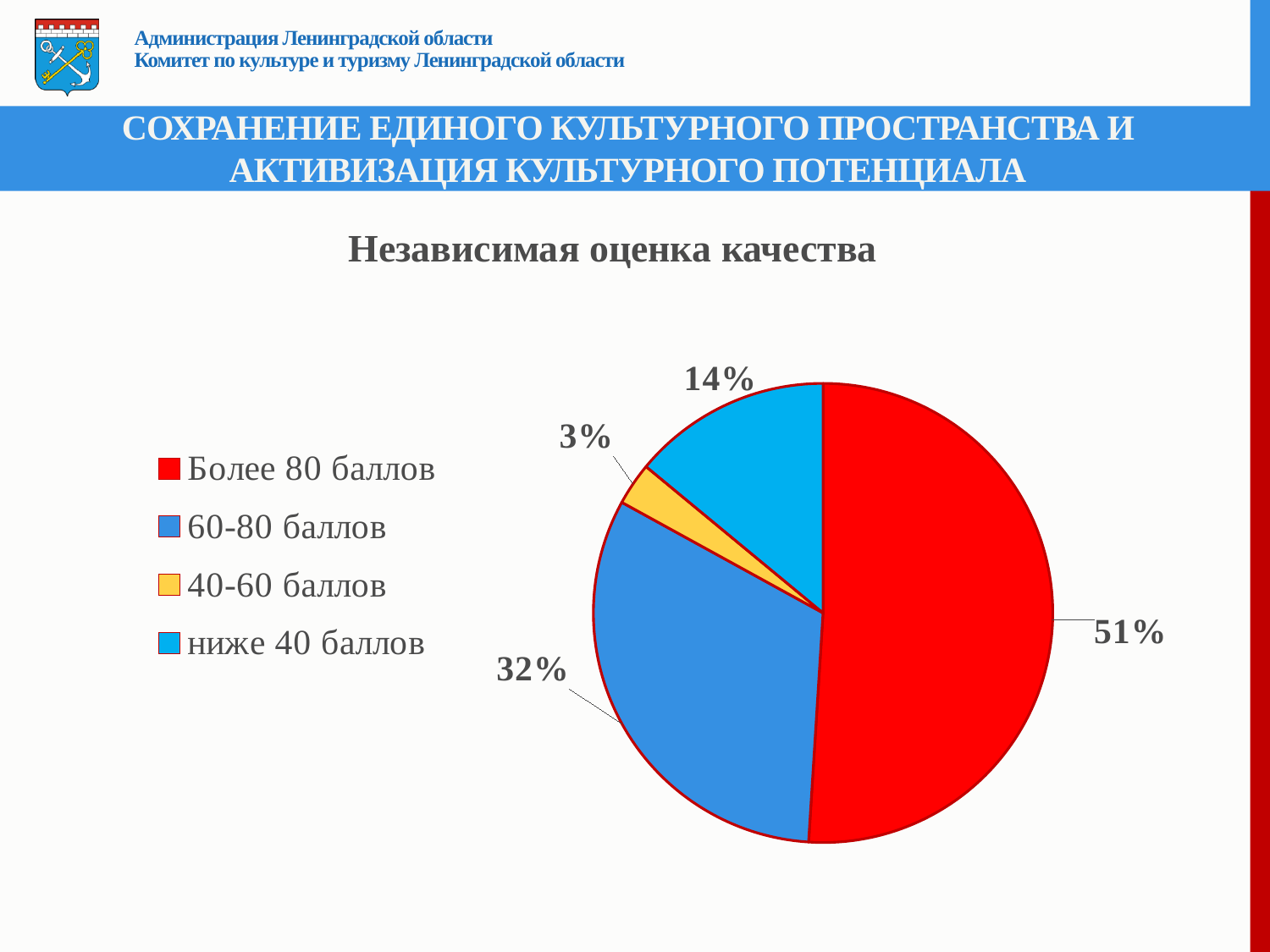
What share of the pie does "ниже 40 баллов" have? 14% What share of the pie does "Более 80 баллов" have? 51% What share of the pie does "60-80 баллов" have? 32% What is the title of the chart? Независимая оценка качества What kind of chart is shown on the slide? pie chart Which category has the largest slice of the pie? Более 80 баллов Which category has the smallest slice of the pie? 40-60 баллов How many categories does the pie chart have? 4 Which is larger, the share for "ниже 40 баллов" or the share for "40-60 баллов"? ниже 40 баллов What is the difference in percentage points between "Более 80 баллов" and "60-80 баллов"? 19 What colour is the slice for "40-60 баллов"? yellow